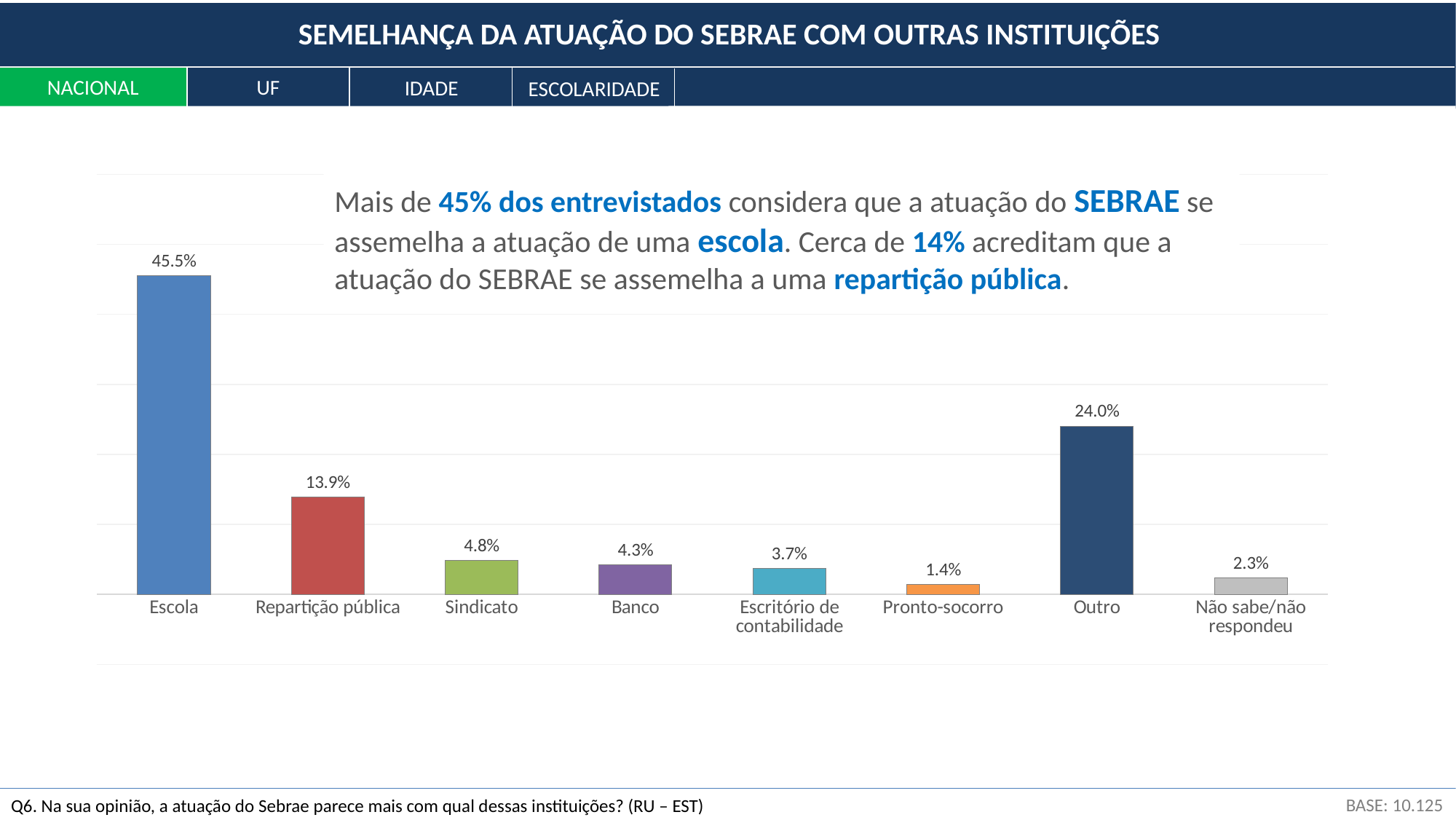
How many categories are shown on the x axis? 8 What is the value for Pronto-socorro? 1.4% What is the difference between the values for Escola and Repartição pública? 31.6% Which category has the highest value? Escola What is the value for Não sabe/não respondeu? 2.3% Which category has the lowest value? Pronto-socorro What kind of chart is shown on the slide? Bar chart What is the value for Outro? 24.0% Which is larger, the value for Sindicato or the value for Banco? Sindicato What is the value for Repartição pública? 13.9% What is the difference between the values for Outro and Escritório de contabilidade? 20.3% What is the value for Escola? 45.5%